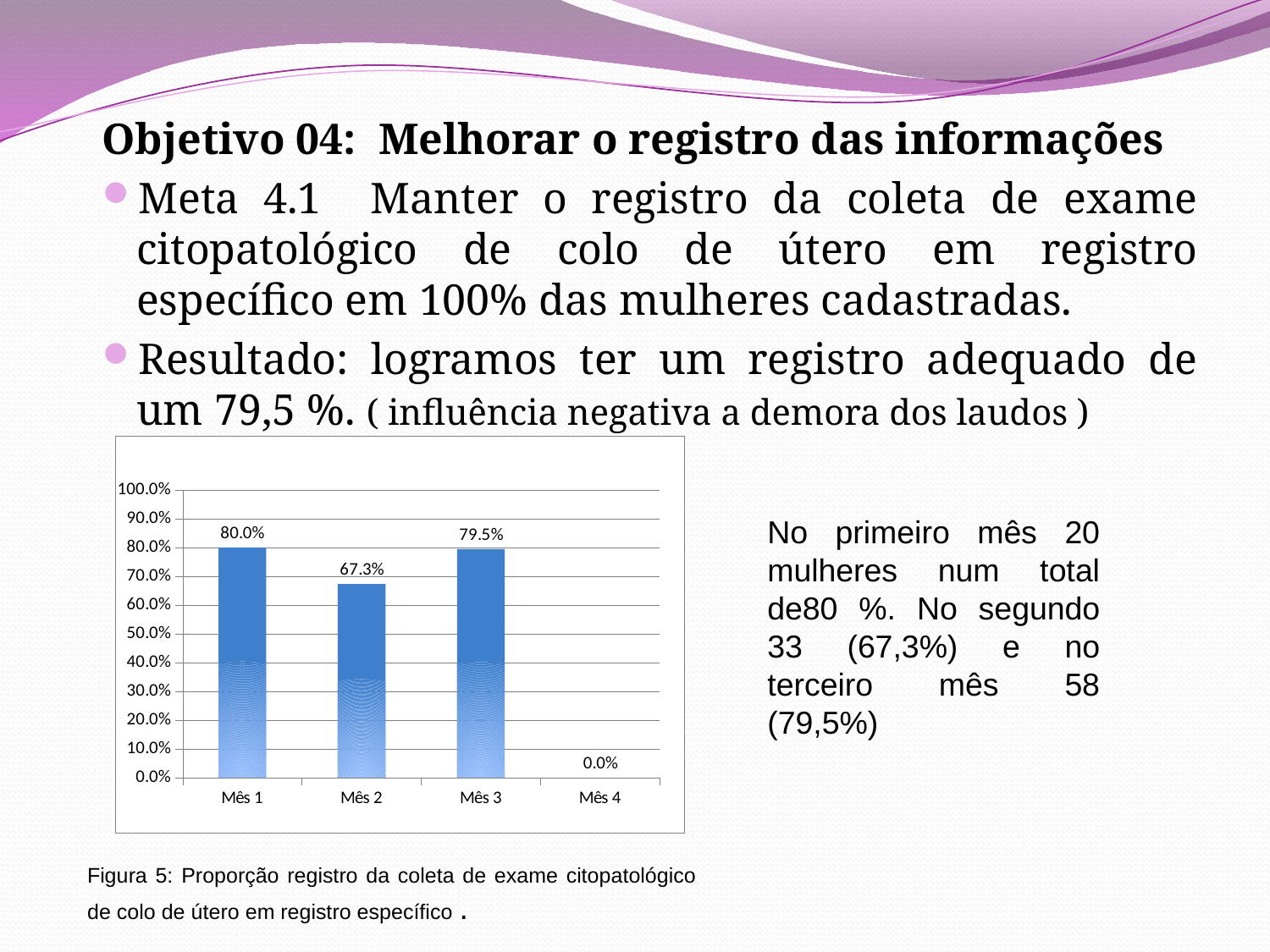
How many months are shown on the x axis? 4 What is the value for Mês 2? 67.3% Which month has the highest value? Mês 1 What is the value for Mês 1? 80.0% What is the value for Mês 4? 0.0% What is the value for Mês 3? 79.5% Is the value for Mês 2 greater or less than 70.0%? less Which month has the lowest value? Mês 4 Does the value rise or fall from Mês 1 to Mês 2? fall What is the difference between the values for Mês 1 and Mês 2? 12.7% What kind of chart is shown on the slide? bar chart Which is larger, the value for Mês 2 or the value for Mês 3? Mês 3